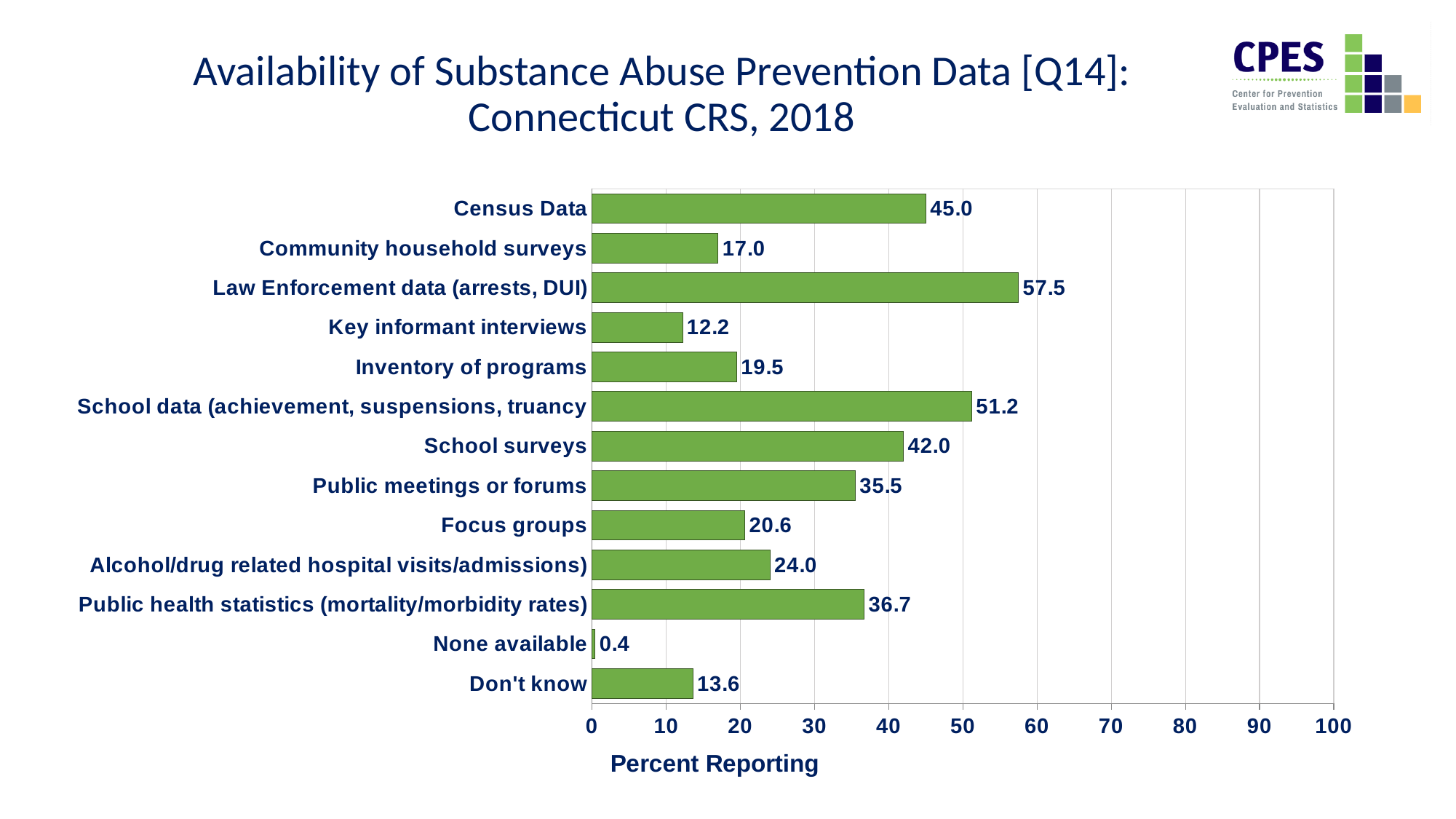
What percent reporting is shown for Key informant interviews? 12.2 What is the difference between the values for School surveys and Focus groups? 21.4 What is the value for Census Data? 45.0 What is the label of the horizontal axis? Percent Reporting What is the value for Don't know? 13.6 What is the value for Public health statistics (mortality/morbidity rates)? 36.7 Which is larger, the value for Public meetings or forums or the value for Alcohol/drug related hospital visits/admissions? Public meetings or forums Which category has the highest value? Law Enforcement data (arrests, DUI) Which category has the lowest value? None available What kind of chart is shown on the slide? bar chart Is the value for School data (achievement, suspensions, truancy) greater or less than 50? greater How many categories are plotted in the chart? 13